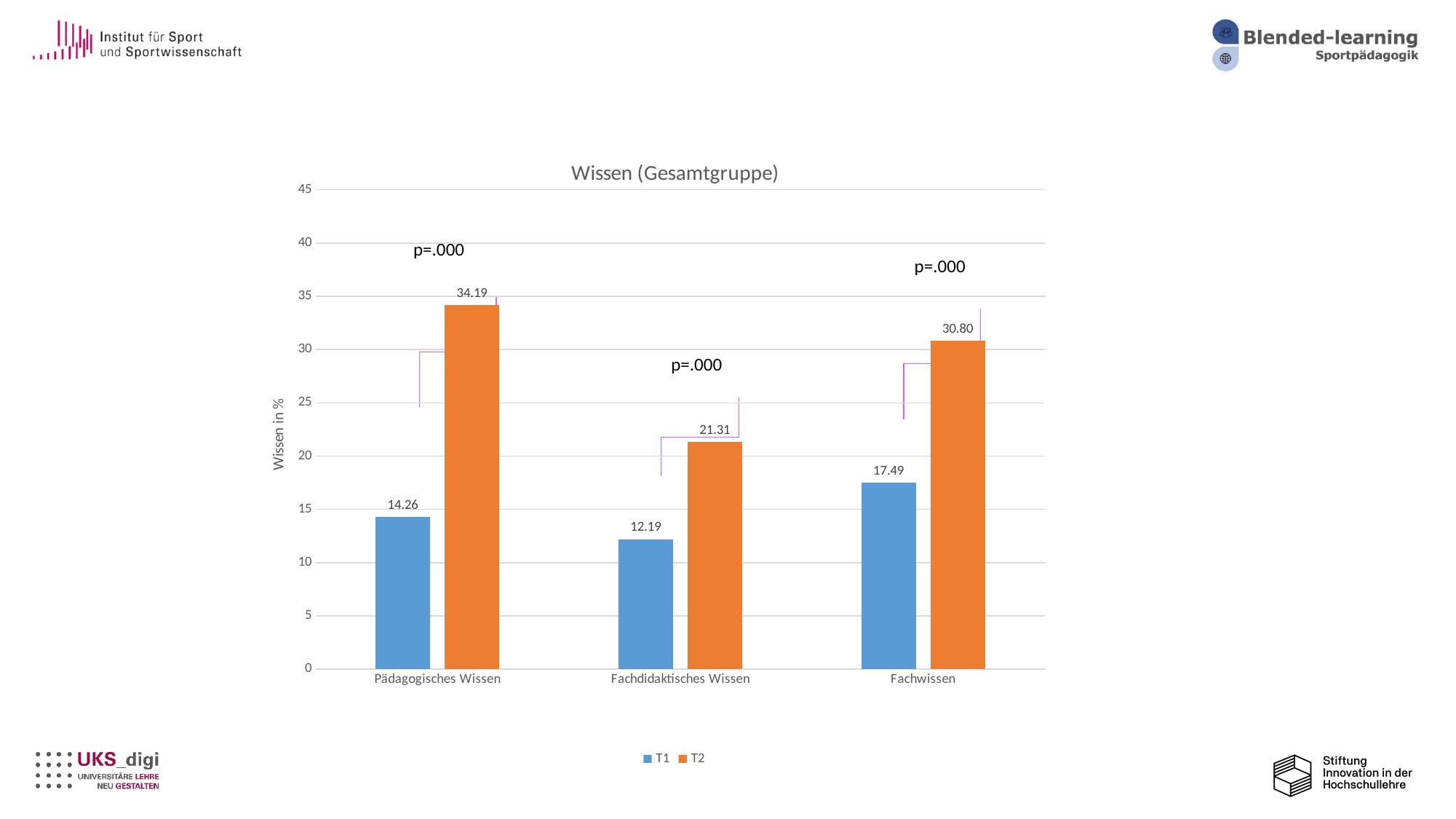
How many categories are shown on the x axis? 3 Is the T2 value for Fachwissen greater or less than 25? greater What is the T2 value for Fachdidaktisches Wissen? 21.31 Which category has the lowest T1 value? Fachdidaktisches Wissen What kind of chart is shown? bar chart What is the T1 value for Pädagogisches Wissen? 14.26 How many series does the legend list? 2 Which is larger, the T1 value for Fachwissen or the T1 value for Pädagogisches Wissen? T1 value for Fachwissen What is the T2 value for Fachwissen? 30.80 What is the title of the chart? Wissen (Gesamtgruppe) What is the difference between the T2 and T1 values for Pädagogisches Wissen? 19.93 Which category has the highest T2 value? Pädagogisches Wissen